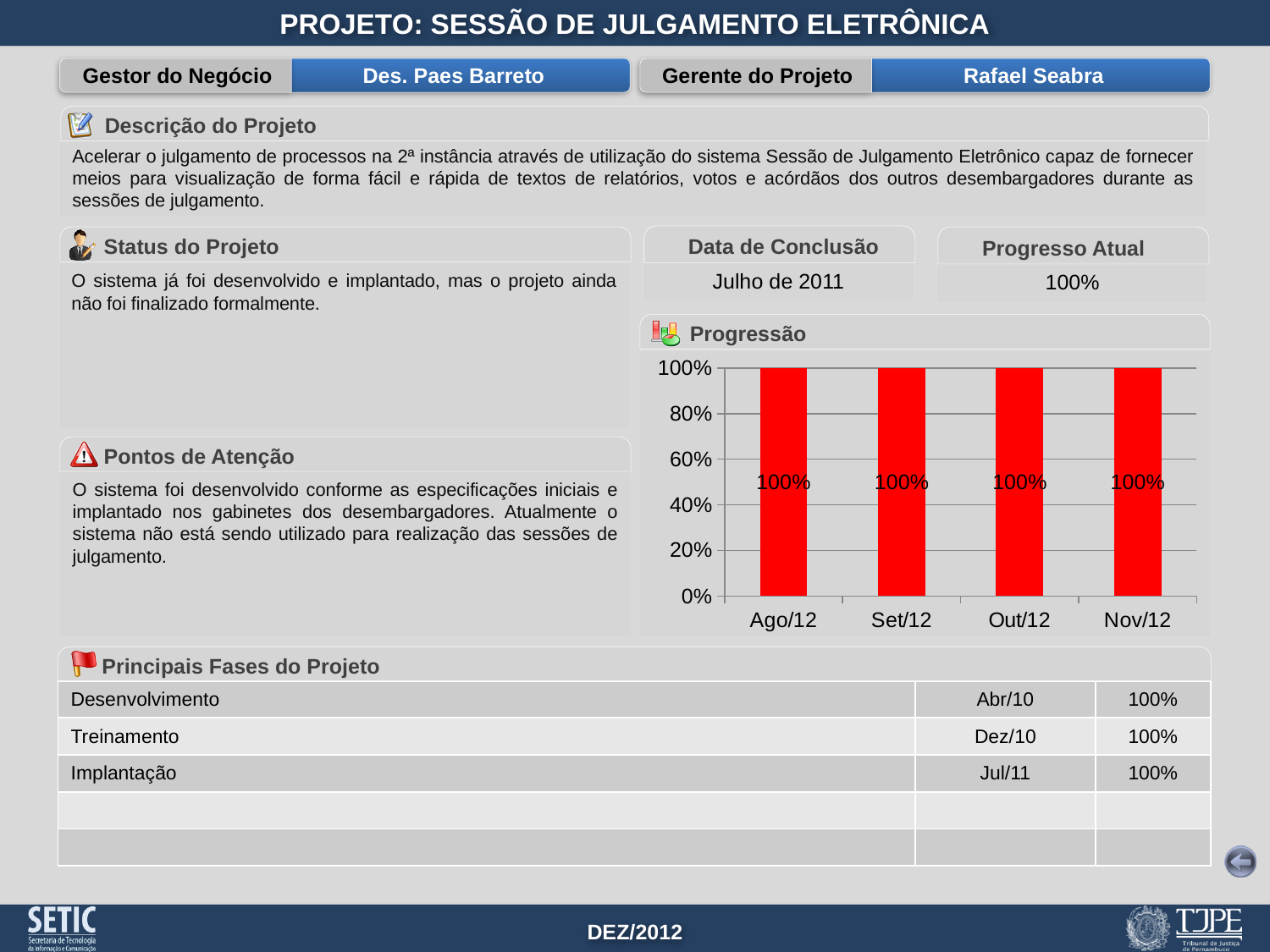
How many categories are shown on the x axis of the Progressão chart? 4 What is the difference between the values for Ago/12 and Nov/12 in the Progressão chart? 0% What kind of chart is the Progressão chart? Bar chart Is the value for Out/12 in the Progressão chart greater or less than 60%? greater What is the value for Nov/12 in the Progressão chart? 100% What is the value for Set/12 in the Progressão chart? 100% What is the value for Out/12 in the Progressão chart? 100% What colour are the bars in the Progressão chart? Red Is the value for Set/12 in the Progressão chart greater or less than 80%? greater Do the values in the Progressão chart rise, fall, or stay the same from Ago/12 to Nov/12? Stay the same What is the title of the chart on the slide? Progressão What is the value for Ago/12 in the Progressão chart? 100%